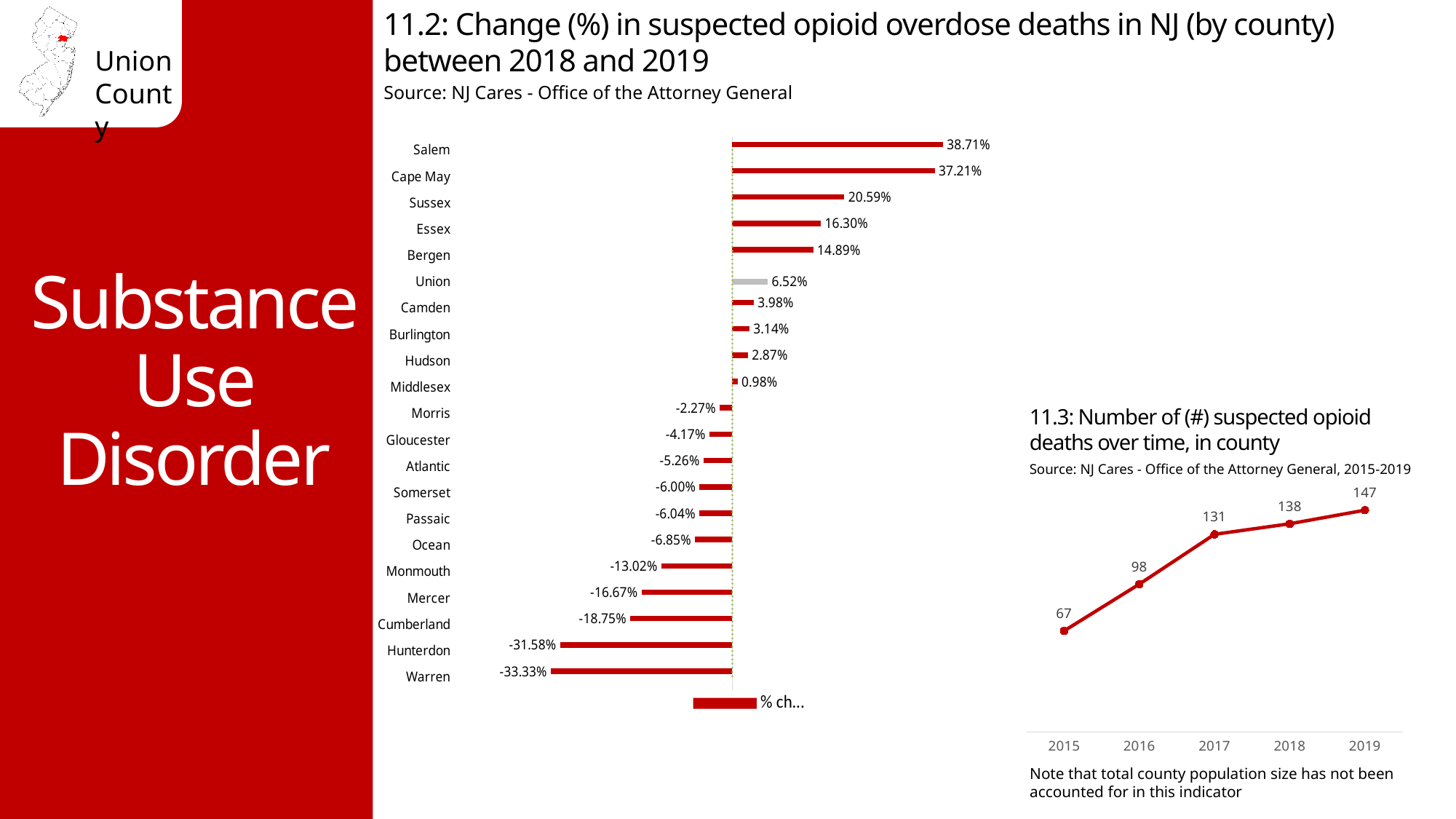
In the chart '11.3: Number of (#) suspected opioid deaths over time, in county', what is the value for 2017? 131 In the chart '11.2: Change (%) in suspected opioid overdose deaths in NJ (by county) between 2018 and 2019', what is the value for Cumberland? -18.75% In the chart '11.3: Number of (#) suspected opioid deaths over time, in county', do the values rise or fall from 2015 to 2019? Rise What kind of chart is '11.3: Number of (#) suspected opioid deaths over time, in county'? Line chart In the chart '11.2: Change (%) in suspected opioid overdose deaths in NJ (by county) between 2018 and 2019', which county's bar is coloured grey instead of red? Union What kind of chart is '11.2: Change (%) in suspected opioid overdose deaths in NJ (by county) between 2018 and 2019'? Bar chart In the chart '11.2: Change (%) in suspected opioid overdose deaths in NJ (by county) between 2018 and 2019', which county has the lowest value? Warren In the chart '11.2: Change (%) in suspected opioid overdose deaths in NJ (by county) between 2018 and 2019', which is larger, the value for Essex or the value for Bergen? Essex In the chart '11.2: Change (%) in suspected opioid overdose deaths in NJ (by county) between 2018 and 2019', what is the value for Union? 6.52% In the chart '11.2: Change (%) in suspected opioid overdose deaths in NJ (by county) between 2018 and 2019', which county has the highest value? Salem In the chart '11.3: Number of (#) suspected opioid deaths over time, in county', what is the difference between the 2019 value and the 2015 value? 80 In the chart '11.2: Change (%) in suspected opioid overdose deaths in NJ (by county) between 2018 and 2019', how many counties are shown? 21